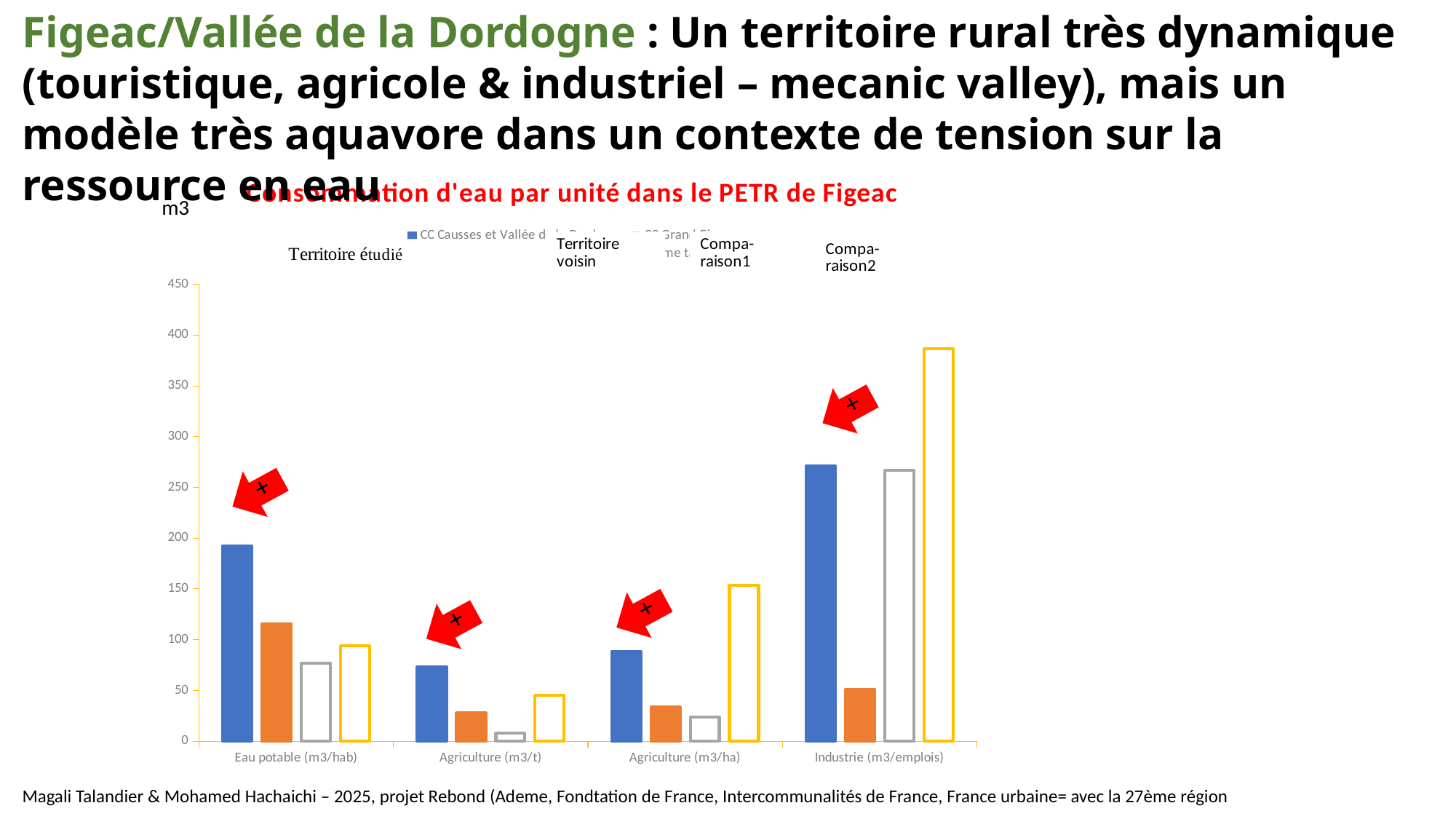
In the Eau potable (m3/hab) category, which is larger: Territoire étudié or Territoire voisin? Territoire étudié In which category is the Territoire étudié bar the highest? Industrie (m3/emplois) Is the value for Comparaison2 in the Industrie (m3/emplois) category greater or less than 350? greater What is the title of the chart? Consommation d'eau par unité dans le PETR de Figeac What unit is indicated at the top of the y axis of the chart? m3 How many categories are shown on the x axis of the chart? 4 Is the value for Territoire étudié in the Industrie (m3/emplois) category greater or less than 250? greater Is the value for Comparaison2 in the Agriculture (m3/ha) category greater or less than 100? greater What kind of chart is shown on the slide? bar chart Which series has the lowest bar in the Agriculture (m3/t) category? Comparaison1